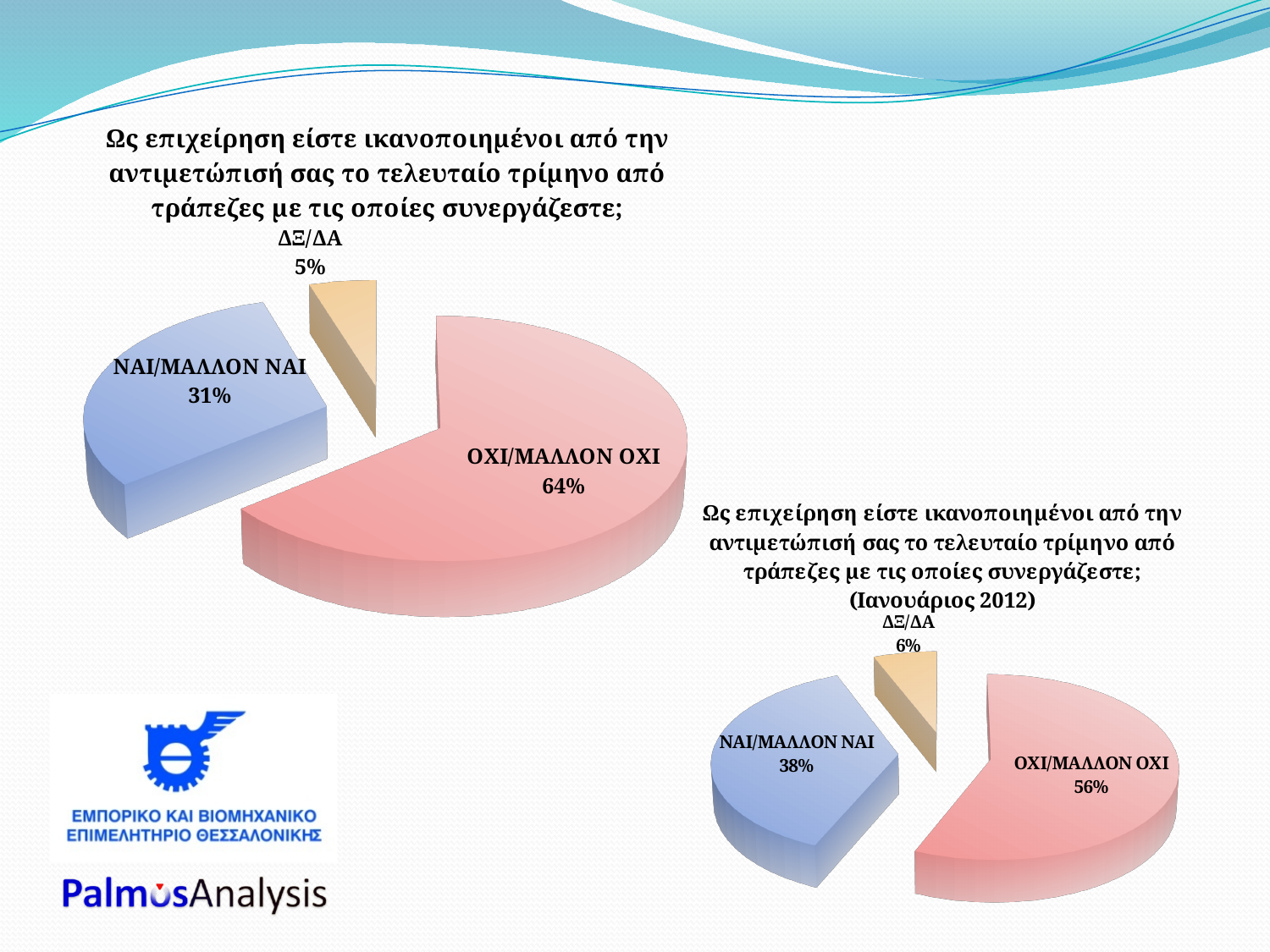
In the bottom-right pie chart (Ιανουάριος 2012), what share is labelled for ΔΞ/ΔΑ? 6% In the top-left pie chart, what share is labelled for ΔΞ/ΔΑ? 5% What type of chart is used on this slide? Pie chart In the bottom-right pie chart (Ιανουάριος 2012), which category has the smallest slice? ΔΞ/ΔΑ Which chart shows a larger share for ΝΑΙ/ΜΑΛΛΟΝ ΝΑΙ, the top-left pie chart or the bottom-right pie chart (Ιανουάριος 2012)? The bottom-right pie chart (Ιανουάριος 2012) In the top-left pie chart, what share is labelled for ΝΑΙ/ΜΑΛΛΟΝ ΝΑΙ? 31% In the bottom-right pie chart (Ιανουάριος 2012), what share is labelled for ΟΧΙ/ΜΑΛΛΟΝ ΟΧΙ? 56% In the top-left pie chart, what is the difference in percentage points between ΟΧΙ/ΜΑΛΛΟΝ ΟΧΙ and ΝΑΙ/ΜΑΛΛΟΝ ΝΑΙ? 33 percentage points In the top-left pie chart, what share is labelled for ΟΧΙ/ΜΑΛΛΟΝ ΟΧΙ? 64% In the bottom-right pie chart (Ιανουάριος 2012), what share is labelled for ΝΑΙ/ΜΑΛΛΟΝ ΝΑΙ? 38% In the top-left pie chart, which category has the largest slice? ΟΧΙ/ΜΑΛΛΟΝ ΟΧΙ How many slices does the top-left pie chart have? 3